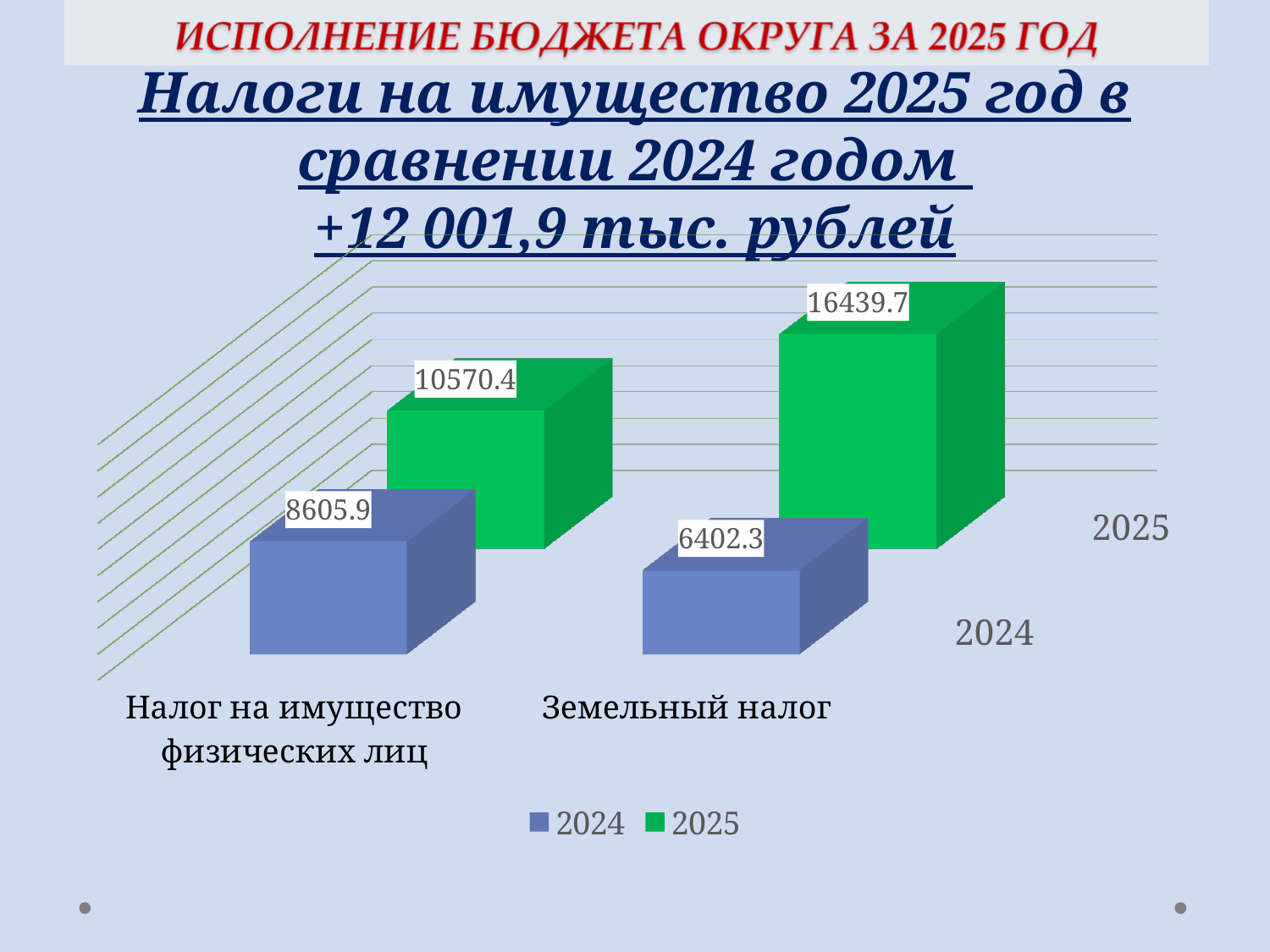
Which category has the highest value in the 2025 series? Земельный налог What is the difference between the 2025 and 2024 values for Земельный налог? 10037.4 What is the value for Налог на имущество физических лиц in 2024? 8605.9 Which category has the lowest value in the 2024 series? Земельный налог What is the value for Земельный налог in 2024? 6402.3 What is the value for Налог на имущество физических лиц in 2025? 10570.4 What is the difference between the 2025 and 2024 values for Налог на имущество физических лиц? 1964.5 Which is larger: the 2024 value for Налог на имущество физических лиц or the 2024 value for Земельный налог? Налог на имущество физических лиц How many series does the legend list? 2 What kind of chart is shown on the slide? Bar chart What is the value for Земельный налог in 2025? 16439.7 How many categories are shown on the x axis of the chart? 2